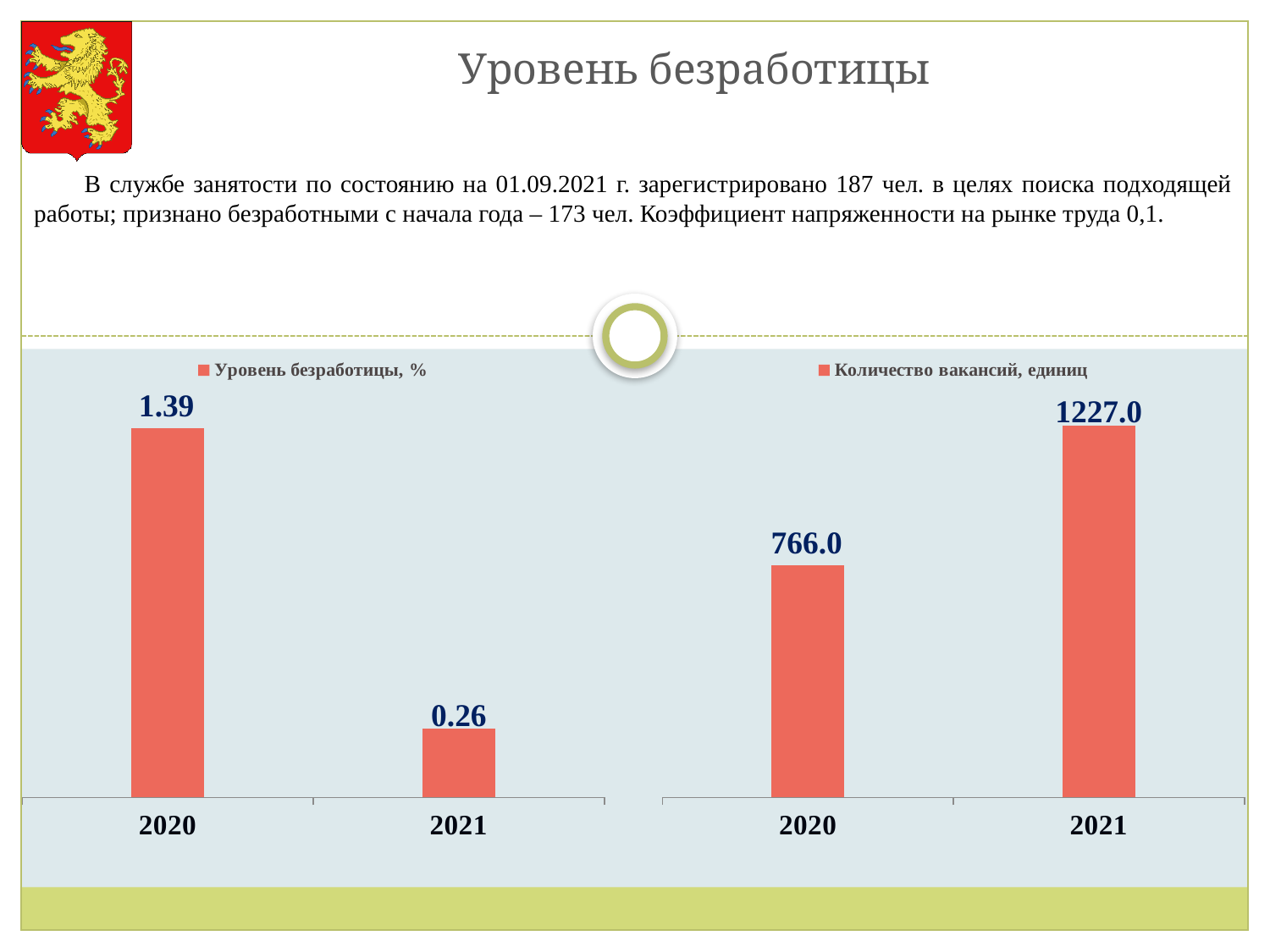
In the right chart (Количество вакансий, единиц), what is the difference between the 2021 and 2020 values? 461.0 In the left chart (Уровень безработицы, %), do the values rise or fall from 2020 to 2021? fall In the right chart (Количество вакансий, единиц), which year has the lower value? 2020 In the right chart (Количество вакансий, единиц), what is the value for 2021? 1227.0 In the left chart (Уровень безработицы, %), what is the value for 2020? 1.39 In the left chart (Уровень безработицы, %), what is the difference between the 2020 and 2021 values? 1.13 What type of chart is the left chart (Уровень безработицы, %)? bar chart How many categories (years) are shown in the right chart (Количество вакансий, единиц)? 2 In the left chart (Уровень безработицы, %), what is the value for 2021? 0.26 In the right chart (Количество вакансий, единиц), what is the value for 2020? 766.0 In the right chart (Количество вакансий, единиц), is the value for 2021 larger or smaller than the value for 2020? larger In the left chart (Уровень безработицы, %), which year has the higher value? 2020